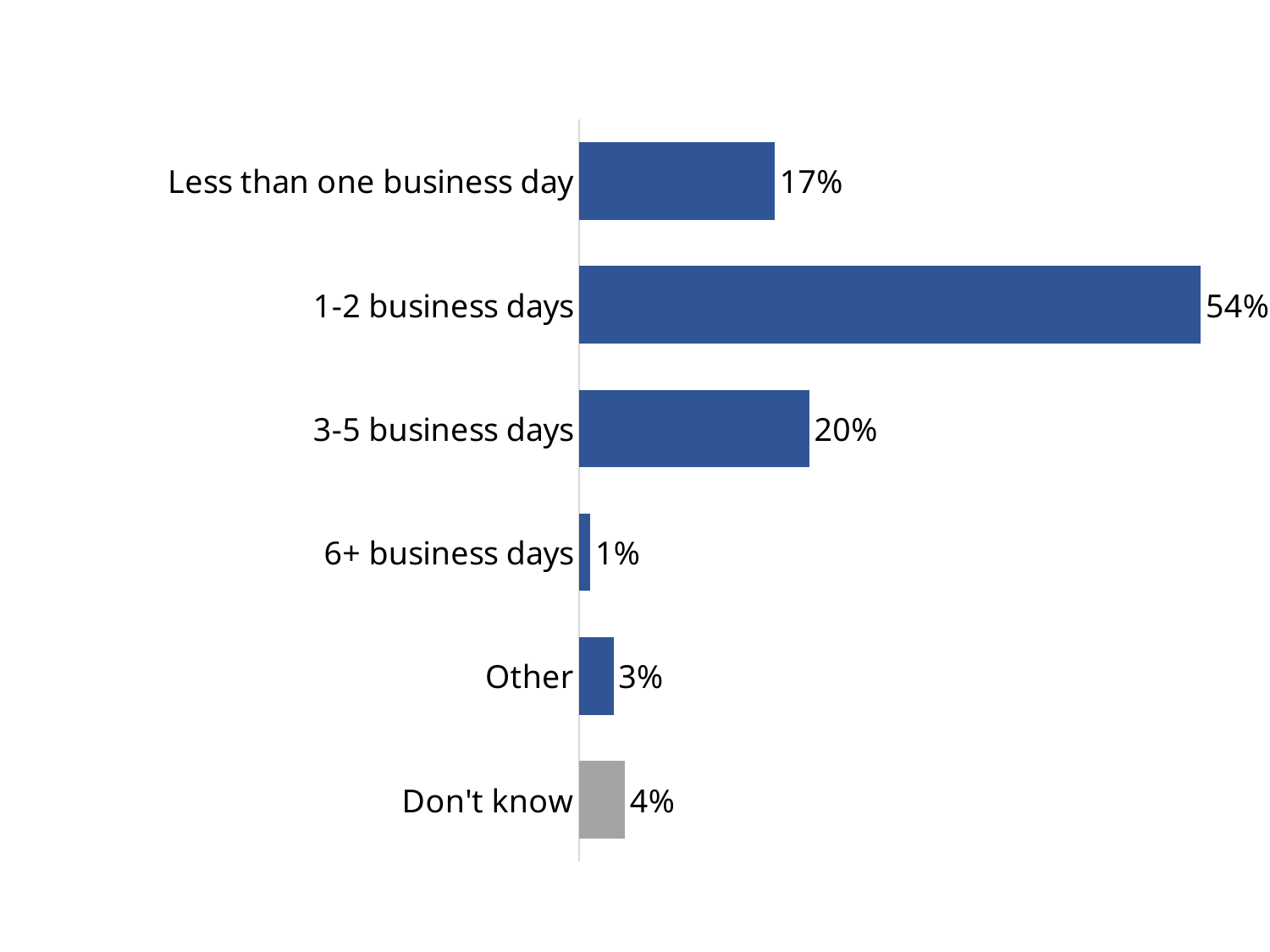
Which category has the highest value? 1-2 business days What kind of chart is this? Bar chart Which category has the lowest value? 6+ business days What is the value for 1-2 business days? 54% What is the value for 3-5 business days? 20% Which is larger, the value for 3-5 business days or the value for Less than one business day? 3-5 business days What is the value for Don't know? 4% What is the difference between the values for Don't know and Other? 1% Which bar is shown in grey rather than blue? Don't know What is the difference between the values for 1-2 business days and 3-5 business days? 34% What is the value for Less than one business day? 17% How many categories are shown in the chart? 6